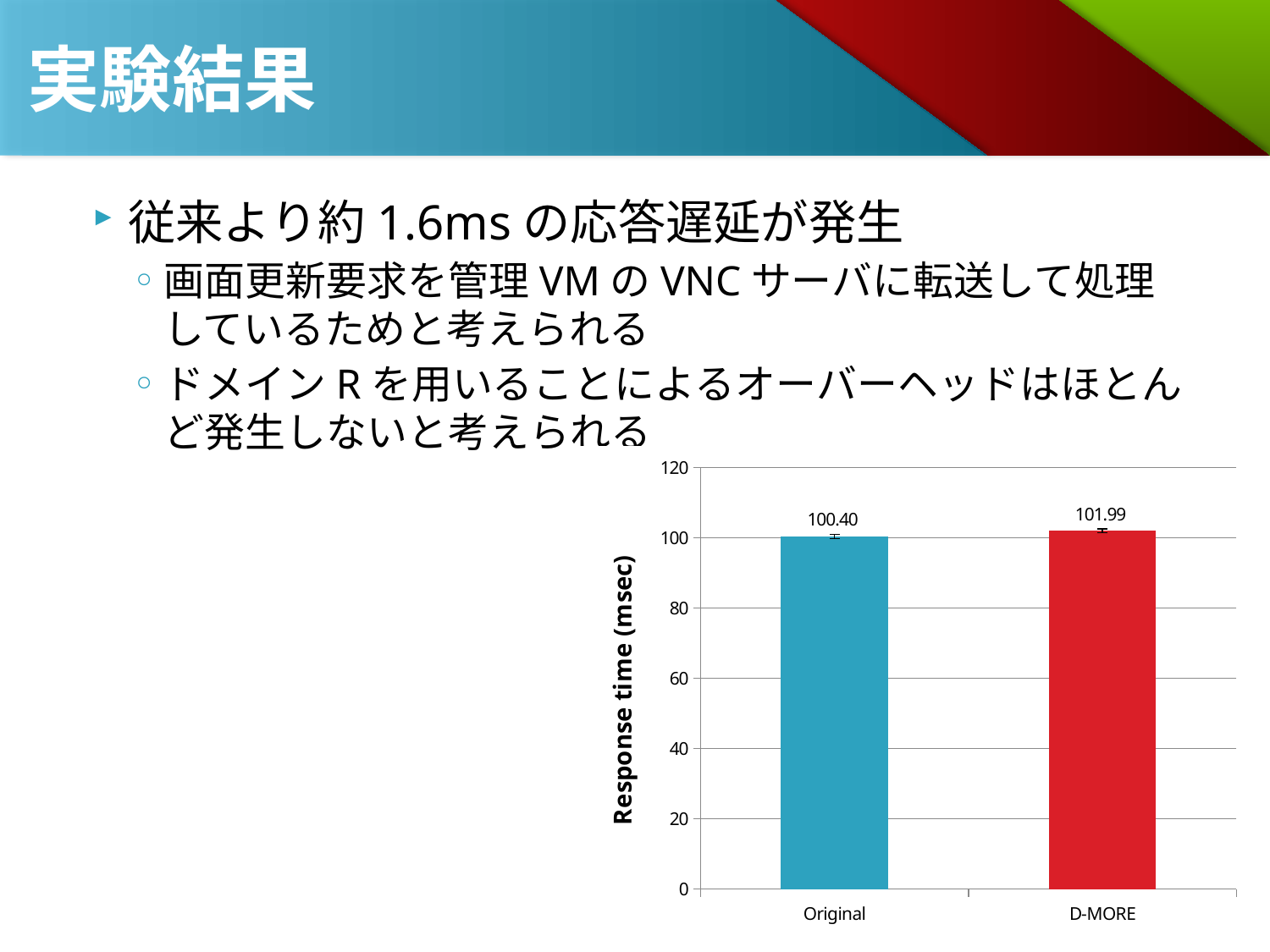
What is the label of the y axis? Response time (msec) Which category has the higher response time? D-MORE What is the difference in response time between D-MORE and Original? 1.59 Is the response time for D-MORE larger or smaller than that for Original? larger How many categories are shown on the x axis? 2 Is the value for D-MORE greater or less than 120? less What is the response time for Original? 100.40 Is the value for Original greater or less than 80? greater What colour is the bar for D-MORE? red What kind of chart is shown on the slide? bar chart Which category has the lower response time? Original What is the response time for D-MORE? 101.99